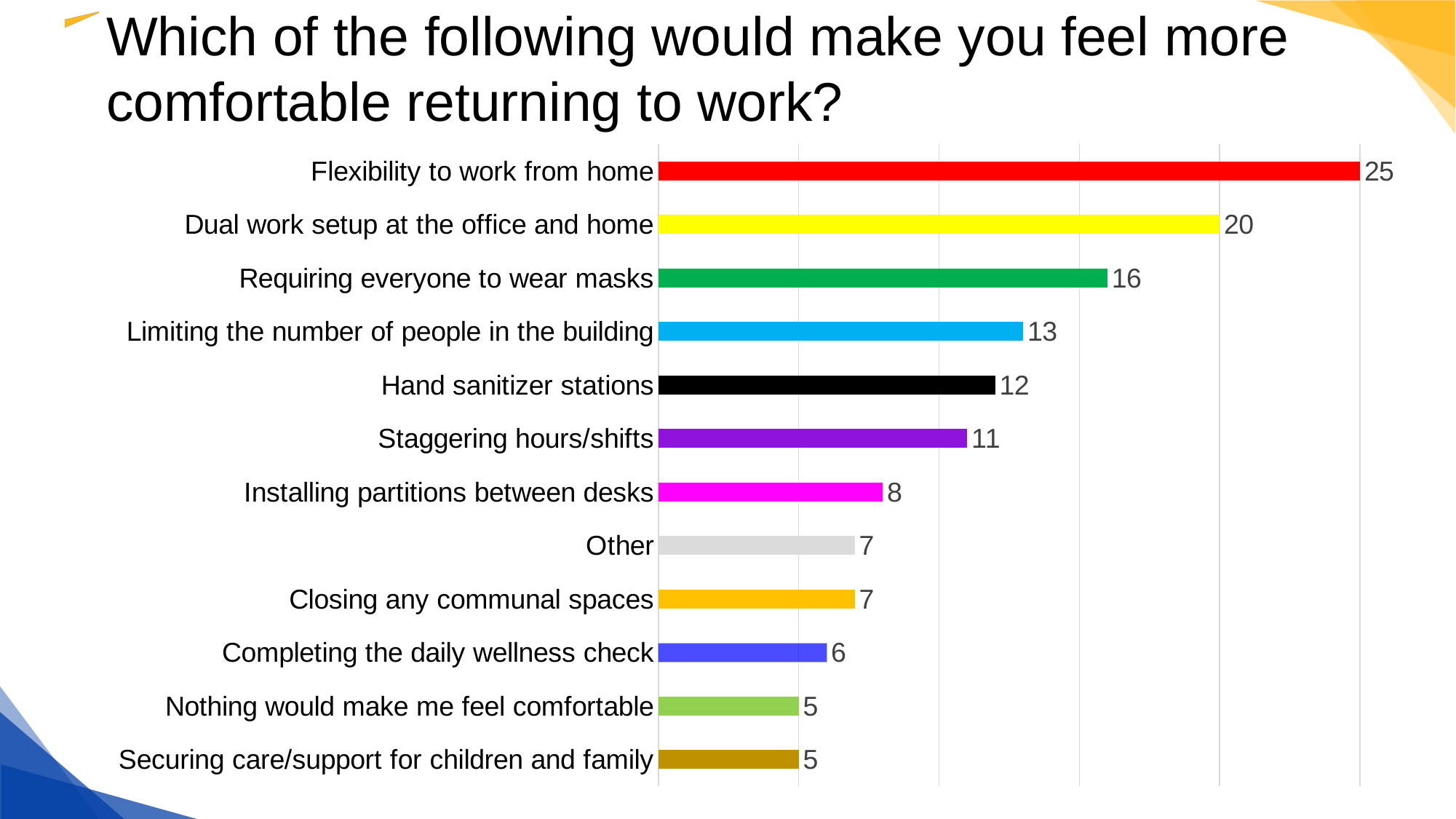
What is the difference between Flexibility to work from home and Dual work setup at the office and home? 5 Which category has the highest value? Flexibility to work from home What is the value for Completing the daily wellness check? 6 Which is larger, Staggering hours/shifts or Closing any communal spaces? Staggering hours/shifts What is the value for Flexibility to work from home? 25 What colour is the bar for Installing partitions between desks? Magenta What is the value for Requiring everyone to wear masks? 16 What kind of chart is shown on the slide? Bar chart Which is larger, Requiring everyone to wear masks or Hand sanitizer stations? Requiring everyone to wear masks What is the value for Hand sanitizer stations? 12 What is the difference between Limiting the number of people in the building and Installing partitions between desks? 5 How many categories are shown in the chart? 12